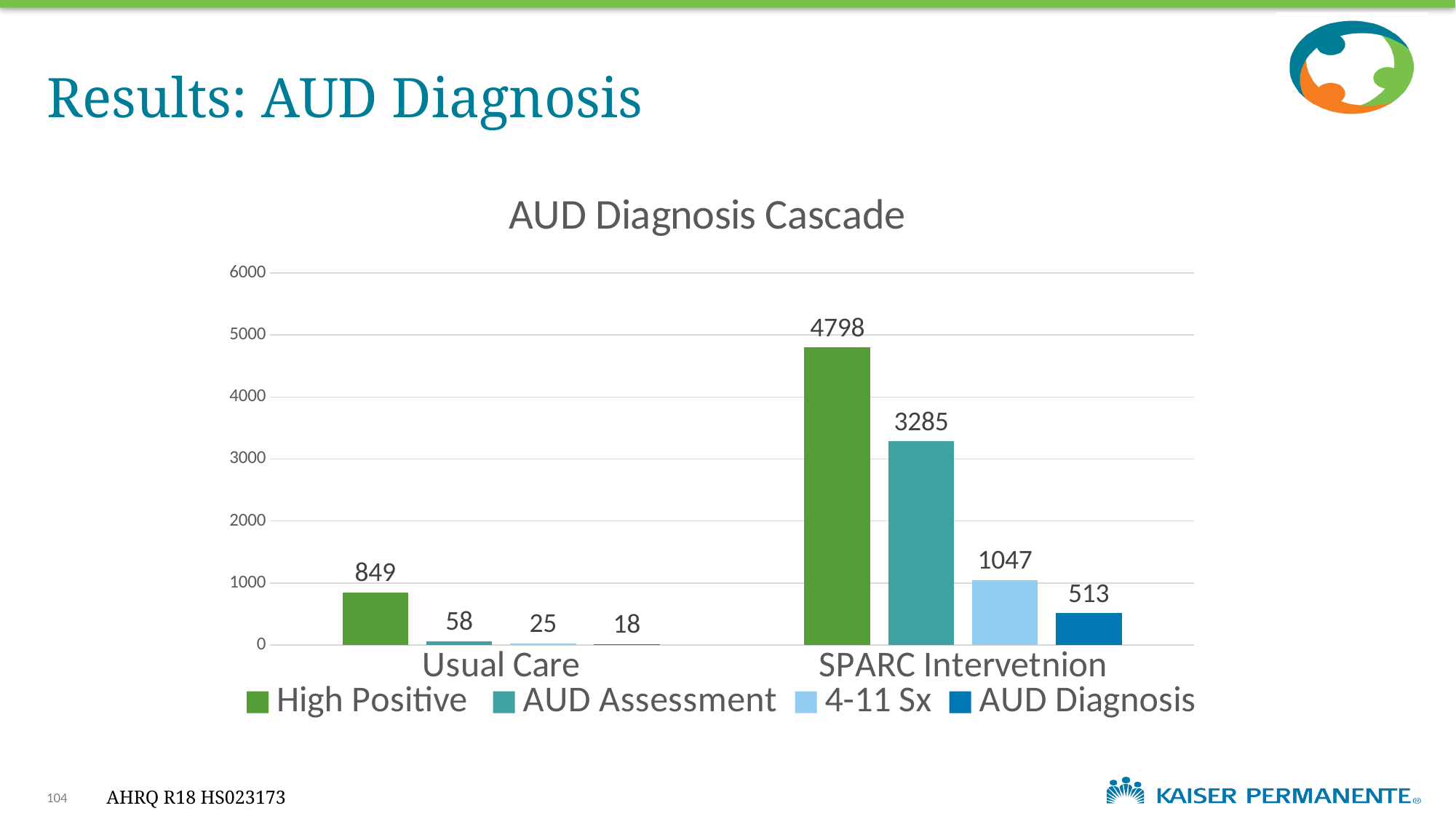
Which series has the lowest value under Usual Care? AUD Diagnosis Which is larger: AUD Assessment under SPARC Intervetnion or 4-11 Sx under SPARC Intervetnion? AUD Assessment under SPARC Intervetnion How many categories are shown on the x axis? 2 What is the value for AUD Assessment under Usual Care? 58 What is the value for High Positive under SPARC Intervetnion? 4798 What is the value for 4-11 Sx under SPARC Intervetnion? 1047 What is the title of the chart? AUD Diagnosis Cascade What is the difference between the High Positive values for SPARC Intervetnion and Usual Care? 3949 How many series does the legend list? 4 What is the value for AUD Diagnosis under Usual Care? 18 What kind of chart is shown on the slide? Bar chart Which series has the highest value under SPARC Intervetnion? High Positive